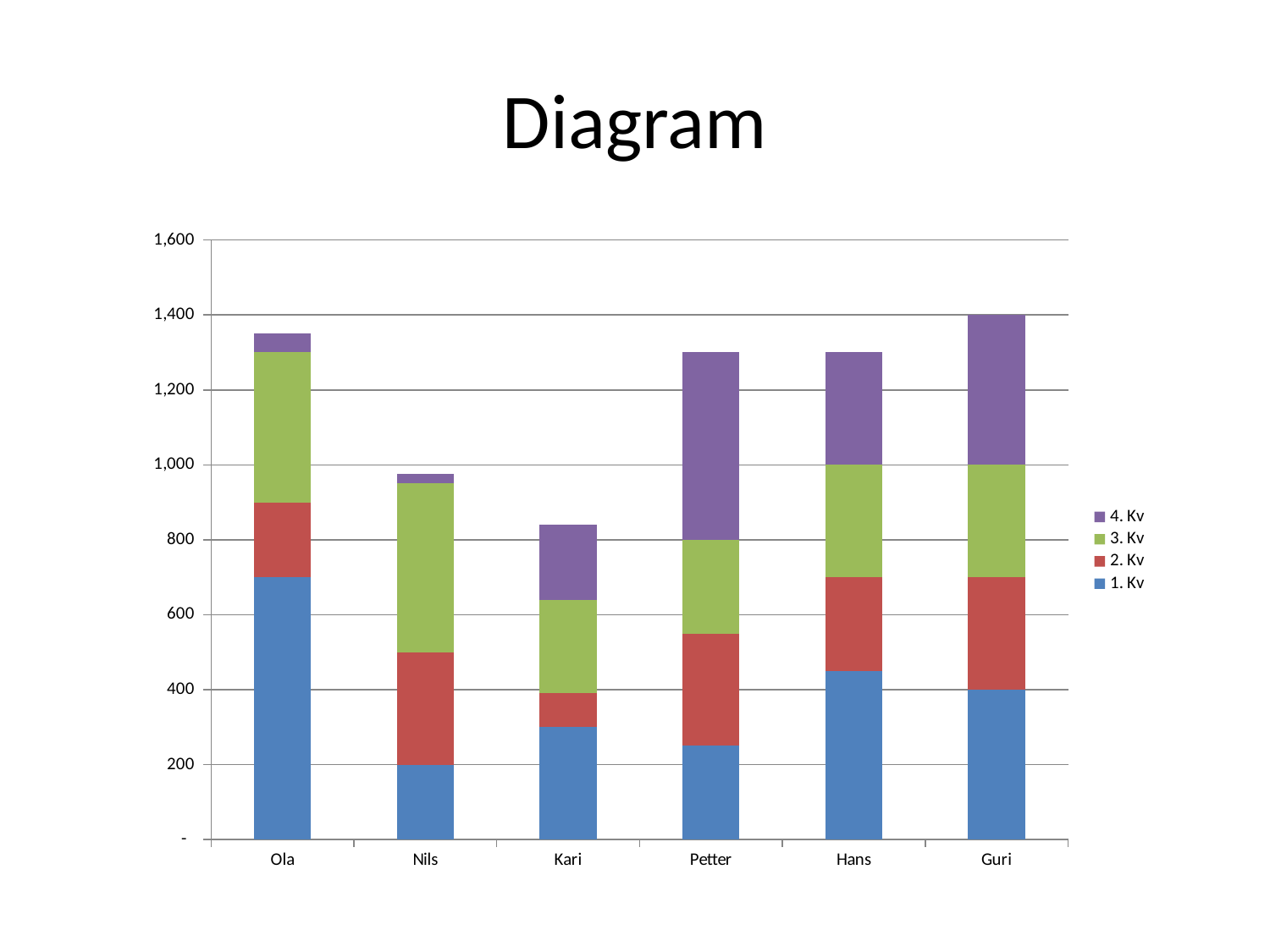
Which is larger, the 4. Kv value for Petter or the 4. Kv value for Ola? Petter How many categories (people) are shown on the x axis? 6 What is the value of 1. Kv for Nils? 200 What is the title of the slide? Diagram What kind of chart is shown on the slide? Stacked bar chart What is the value of 1. Kv for Guri? 400 Is the total for Ola greater or less than 1,200? greater Is the total for Kari greater or less than 1,000? less Is the 1. Kv value for Ola greater or less than 600? greater What is the total of the stacked bar for Guri? 1,400 How many series does the legend list? 4 Which person has the lowest total stacked bar? Kari